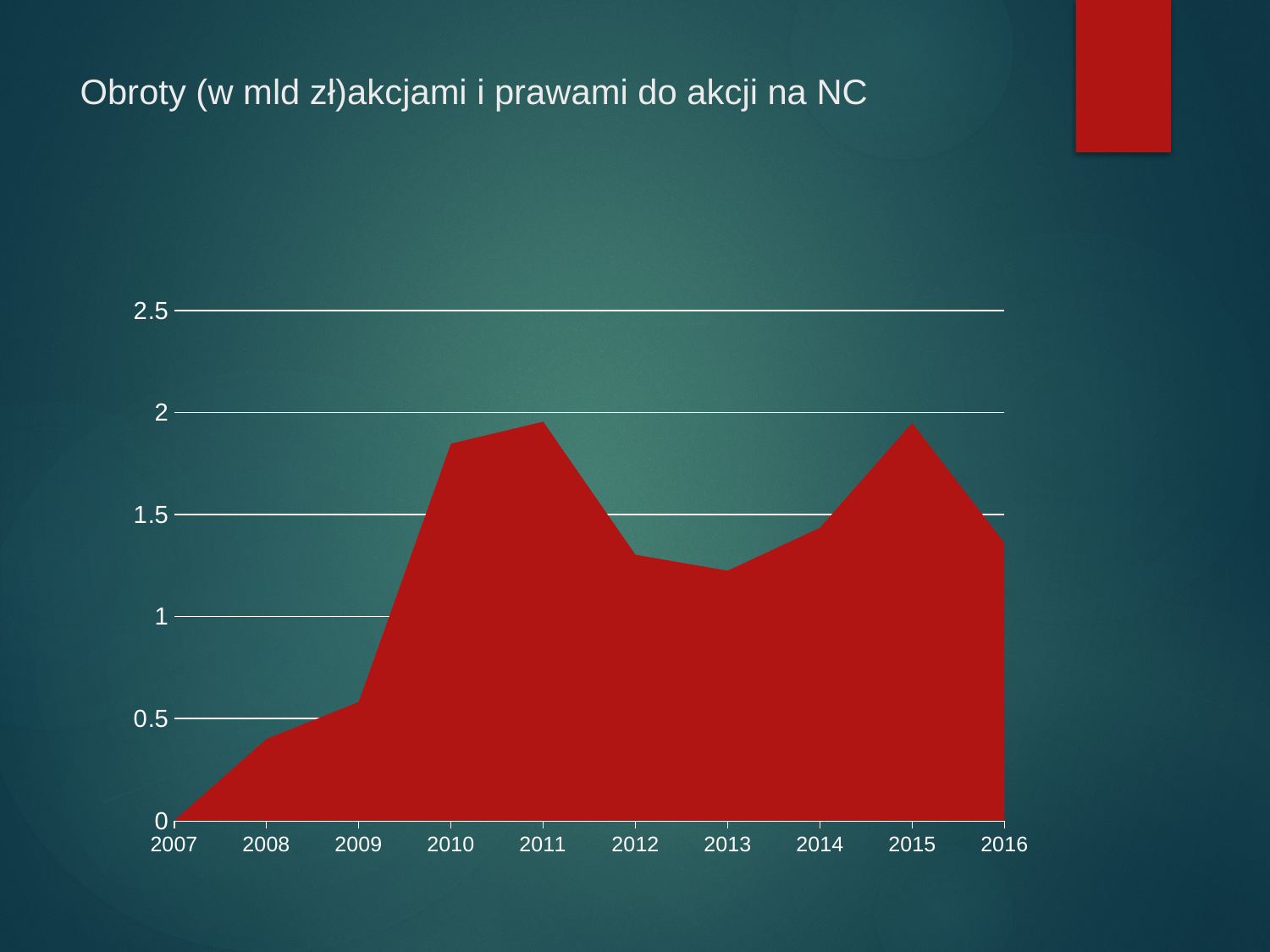
Which year has the lowest value in the chart? 2007 Do the values rise or fall from 2007 to 2011? rise Is the value for 2016 greater or less than 1.5? less Which year has the larger value, 2010 or 2012? 2010 Which year has the larger value, 2008 or 2009? 2009 Is the value for 2008 greater or less than 0.5? less Is the value for 2010 greater or less than 1.5? greater What is the title of the chart? Obroty (w mld zł)akcjami i prawami do akcji na NC What kind of chart is shown on the slide? area chart How many years are shown on the x axis of the chart? 10